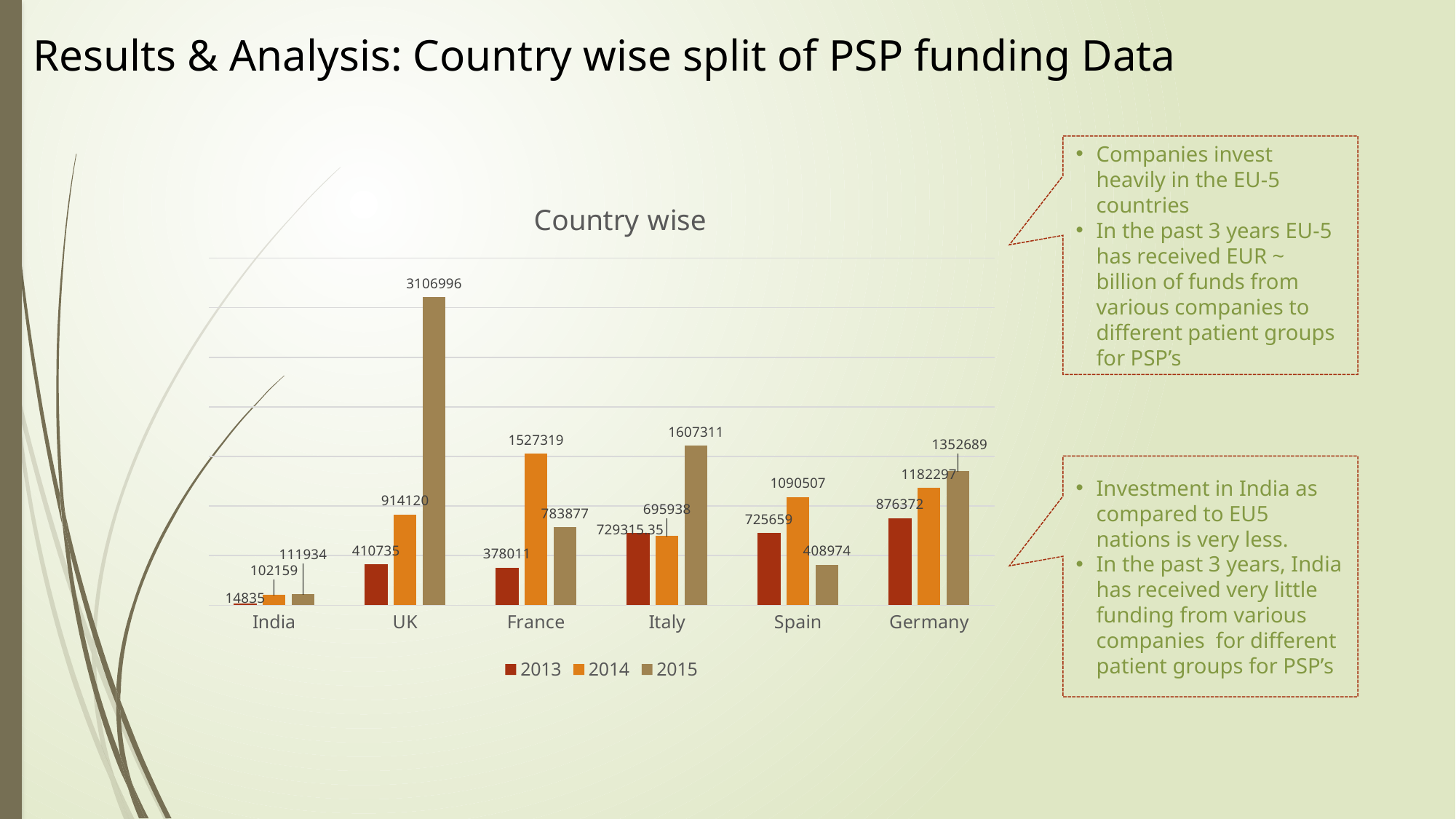
What is the value for India in 2013? 14835 How many series does the legend list? 3 How many countries are shown on the x axis? 6 What is the value for the UK in 2015? 3106996 Which country has the highest value in 2015? UK What kind of chart is shown? Bar chart What is the value for Italy in 2013? 729315.35 What is the title of the chart? Country wise Which is larger, Spain's 2014 value or Italy's 2014 value? Spain's 2014 value Which country has the lowest value in 2013? India What is the difference between Germany's 2015 and 2014 values? 170392 What is the value for France in 2014? 1527319